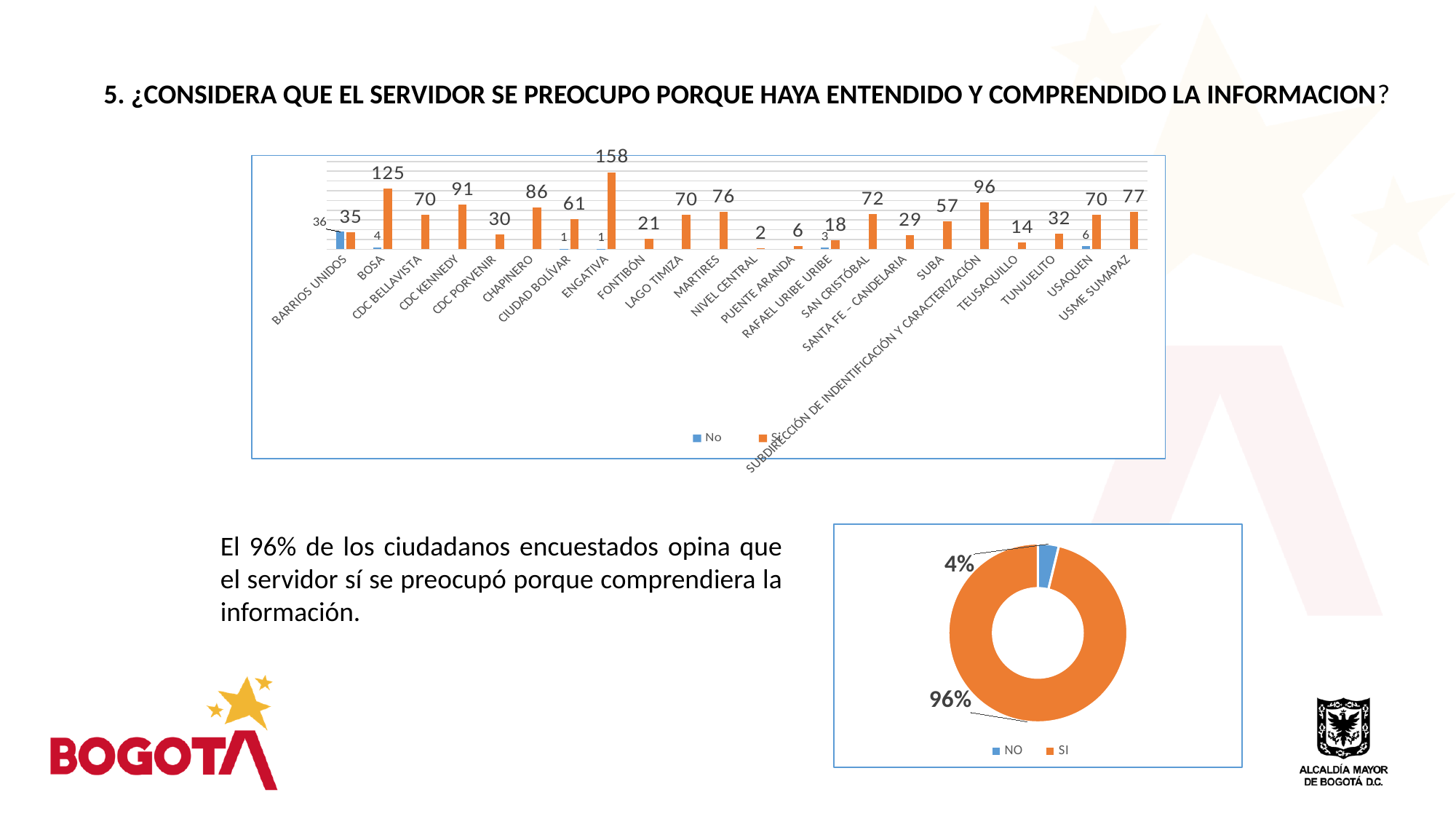
In the top bar chart, what is the difference between the 'Si' values for ENGATIVA and BOSA? 33 In the top bar chart, which category has the lowest 'Si' value? NIVEL CENTRAL In the bottom-right doughnut chart, what share is labelled for SI? 96% In the top bar chart, what is the 'Si' value for BOSA? 125 What kind of chart is the top chart on the slide? Bar chart How many categories are shown on the x axis of the top bar chart? 22 In the bottom-right doughnut chart, what share is labelled for NO? 4% How many series does the legend of the top bar chart list? 2 In the top bar chart, which category has the highest 'Si' value? ENGATIVA In the top bar chart, which has a larger 'Si' value, CDC KENNEDY or CHAPINERO? CDC KENNEDY In the top bar chart, what is the 'Si' value for ENGATIVA? 158 In the top bar chart, what is the 'No' value for BARRIOS UNIDOS? 36